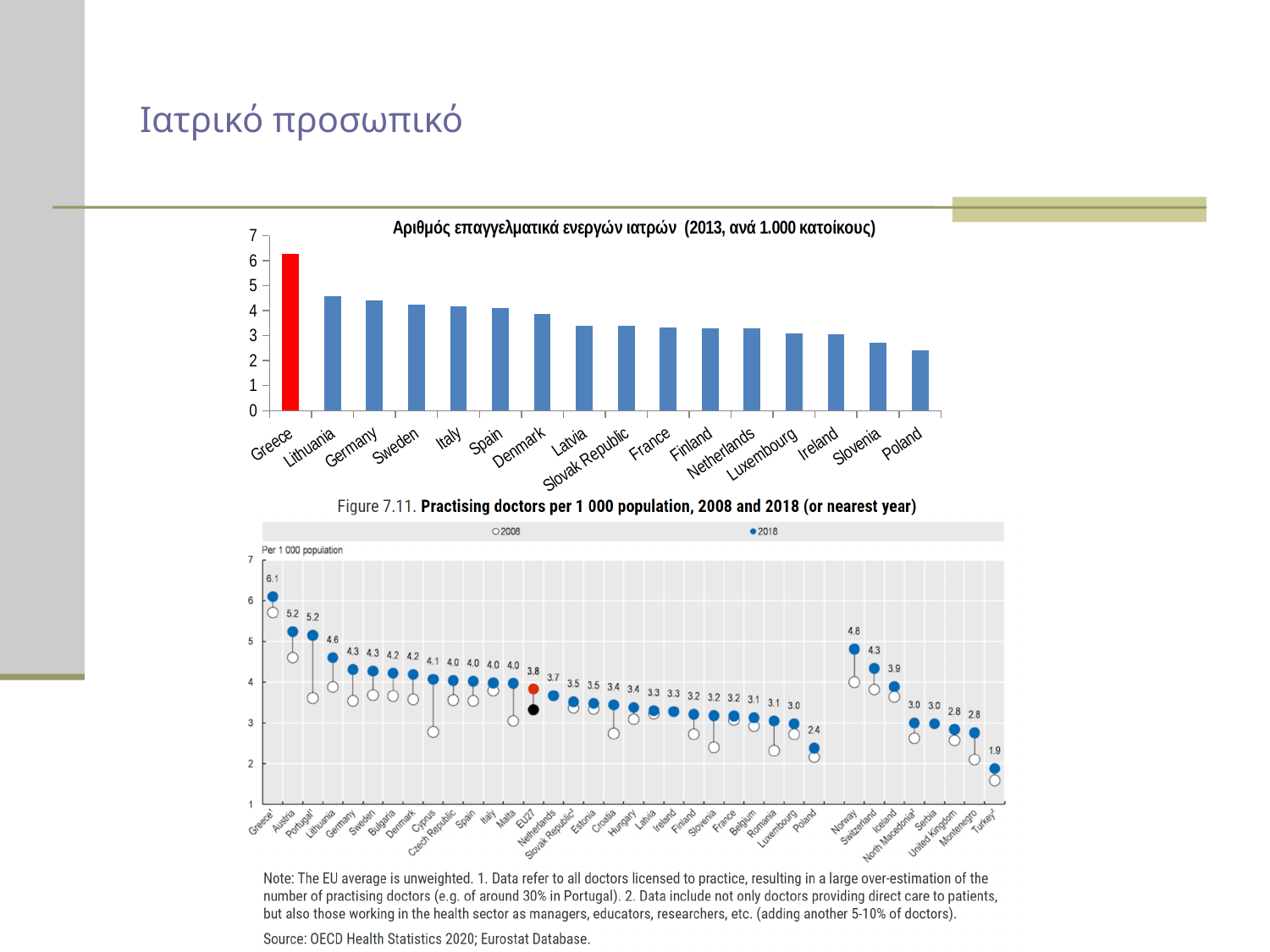
In the top bar chart, which bar is coloured red? Greece In Figure 7.11 (bottom chart), what is the difference between the 2018 values for Greece and Poland? 3.7 In the top bar chart, how many countries are shown? 16 In the top bar chart, which country has the highest value? Greece In Figure 7.11 (bottom chart), how many series does the legend list? 2 In Figure 7.11 (bottom chart), what is the 2018 value for EU27? 3.8 In the top bar chart, is the value for Greece greater or less than 6? greater In the top bar chart, is the value for Poland greater or less than 3? less In Figure 7.11 (bottom chart), what is the 2018 value for Greece? 6.1 In the top bar chart, which country has the lowest value? Poland In Figure 7.11 (bottom chart), which has the larger 2018 value, Norway or Iceland? Norway What kind of chart is the top chart titled 'Αριθμός επαγγελματικά ενεργών ιατρών (2013, ανά 1.000 κατοίκους)'? Bar chart